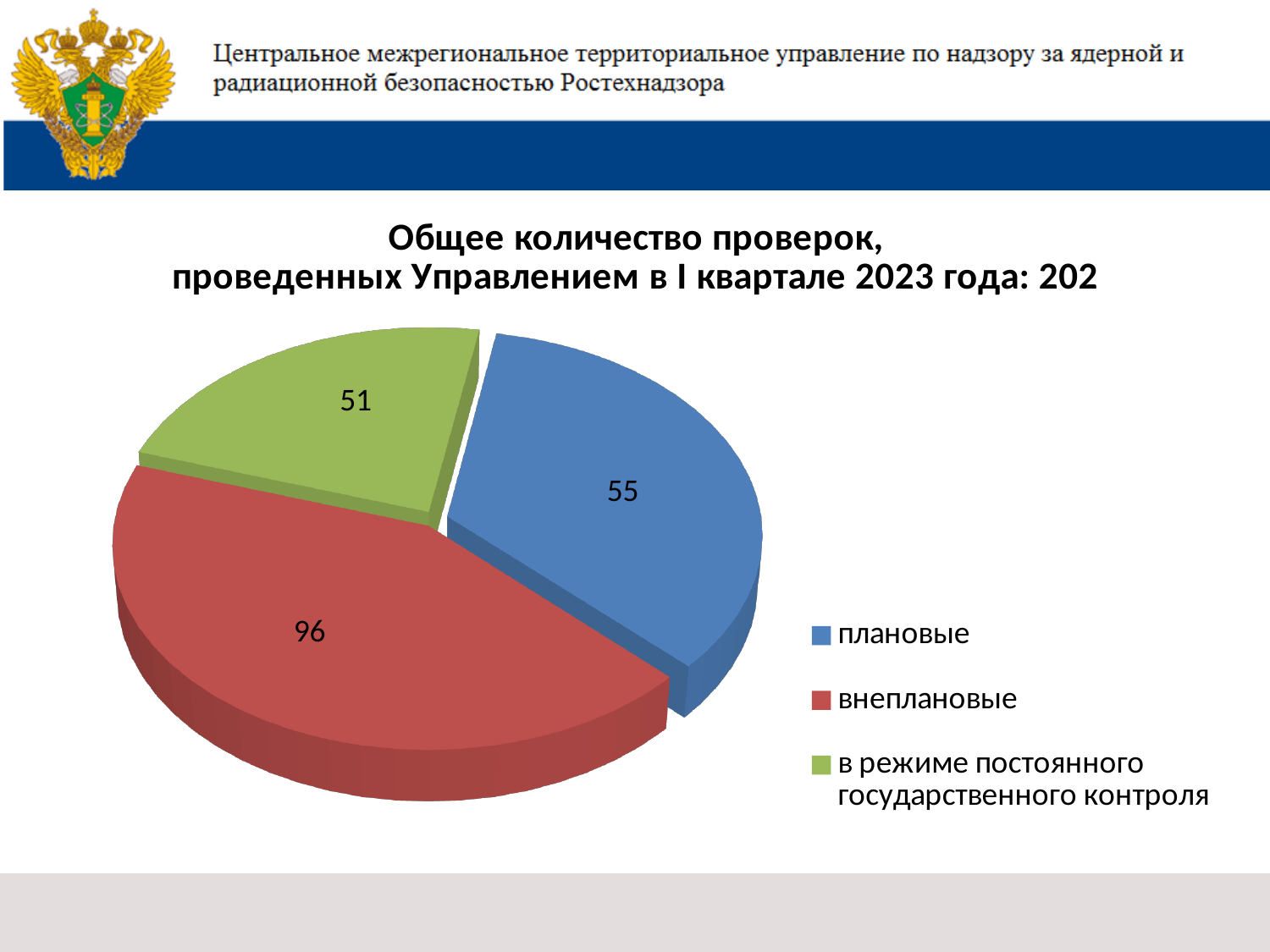
Which category has the largest number of inspections? внеплановые What colour is the slice for внеплановые inspections? red What is the difference between the number of плановые inspections and those в режиме постоянного государственного контроля? 4 Which is larger: the number of внеплановые inspections or the number of плановые inspections? внеплановые Which category has the smallest number of inspections? в режиме постоянного государственного контроля What type of chart is shown on the slide? pie chart How many categories does the pie chart have? 3 What is the difference between the number of внеплановые and плановые inspections? 41 What is the total number of inspections stated in the chart title? 202 How many inspections were внеплановые (unplanned)? 96 How many inspections were плановые (planned)? 55 How many inspections were conducted в режиме постоянного государственного контроля? 51